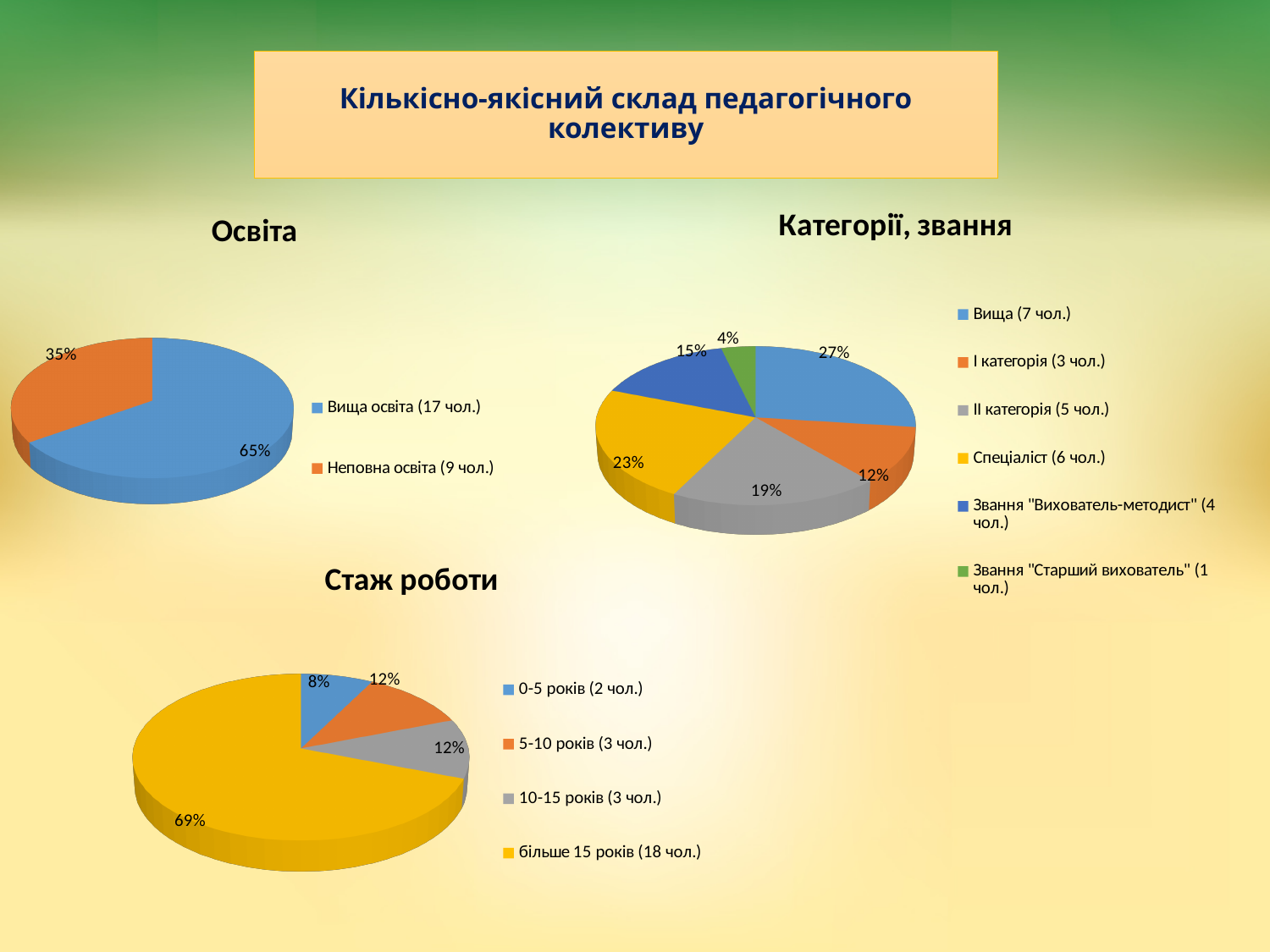
In the "Категорії, звання" chart, which category has the smallest slice? Звання "Старший вихователь" (1 чол.) In the "Категорії, звання" chart, which category has the largest slice? Вища (7 чол.) How many entries does the legend of the "Категорії, звання" chart list? 6 In the "Категорії, звання" chart, what is the difference in percentage points between "II категорія (5 чол.)" and "I категорія (3 чол.)"? 7 What is the title of the chart in the bottom-left of the slide? Стаж роботи In the "Стаж роботи" chart, what share of the pie is "більше 15 років (18 чол.)"? 69% In the "Стаж роботи" chart, which is larger: "0-5 років (2 чол.)" or "5-10 років (3 чол.)"? 5-10 років (3 чол.) In the "Освіта" chart, what share of the pie is "Вища освіта (17 чол.)"? 65% In the "Освіта" chart, what percentage is shown for "Неповна освіта (9 чол.)"? 35% How many categories are shown in the "Стаж роботи" chart? 4 In the "Категорії, звання" chart, what percentage is shown for "Спеціаліст (6 чол.)"? 23% What kind of chart is the "Освіта" chart? Pie chart